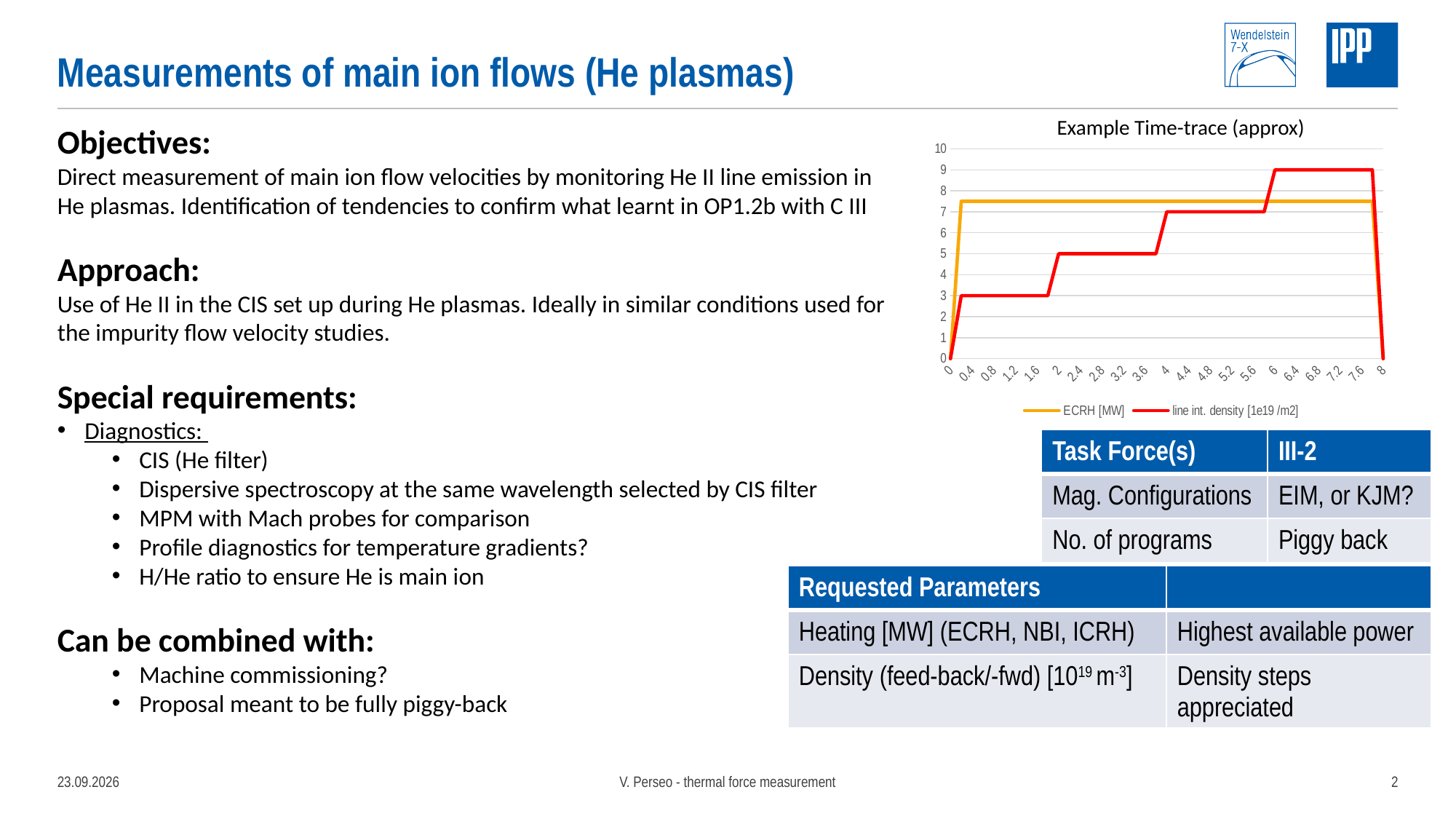
At x = 1, which series has the larger value, ECRH [MW] or line int. density [1e19 /m2]? ECRH [MW] At x = 7, which series has the larger value, ECRH [MW] or line int. density [1e19 /m2]? line int. density [1e19 /m2] What type of chart is shown on the slide? line chart What is the value of line int. density [1e19 /m2] at x = 5? 7 What is the title of the chart? Example Time-trace (approx) Which series is drawn in red in the chart? line int. density [1e19 /m2] What is the value of line int. density [1e19 /m2] at x = 3? 5 Is the value of ECRH [MW] at x = 4 greater or less than 8? less What is the value of line int. density [1e19 /m2] at x = 1? 3 How many series does the chart legend list? 2 What is the highest value reached by the line int. density [1e19 /m2] series? 9 Is the value of ECRH [MW] at x = 4 greater or less than 7? greater